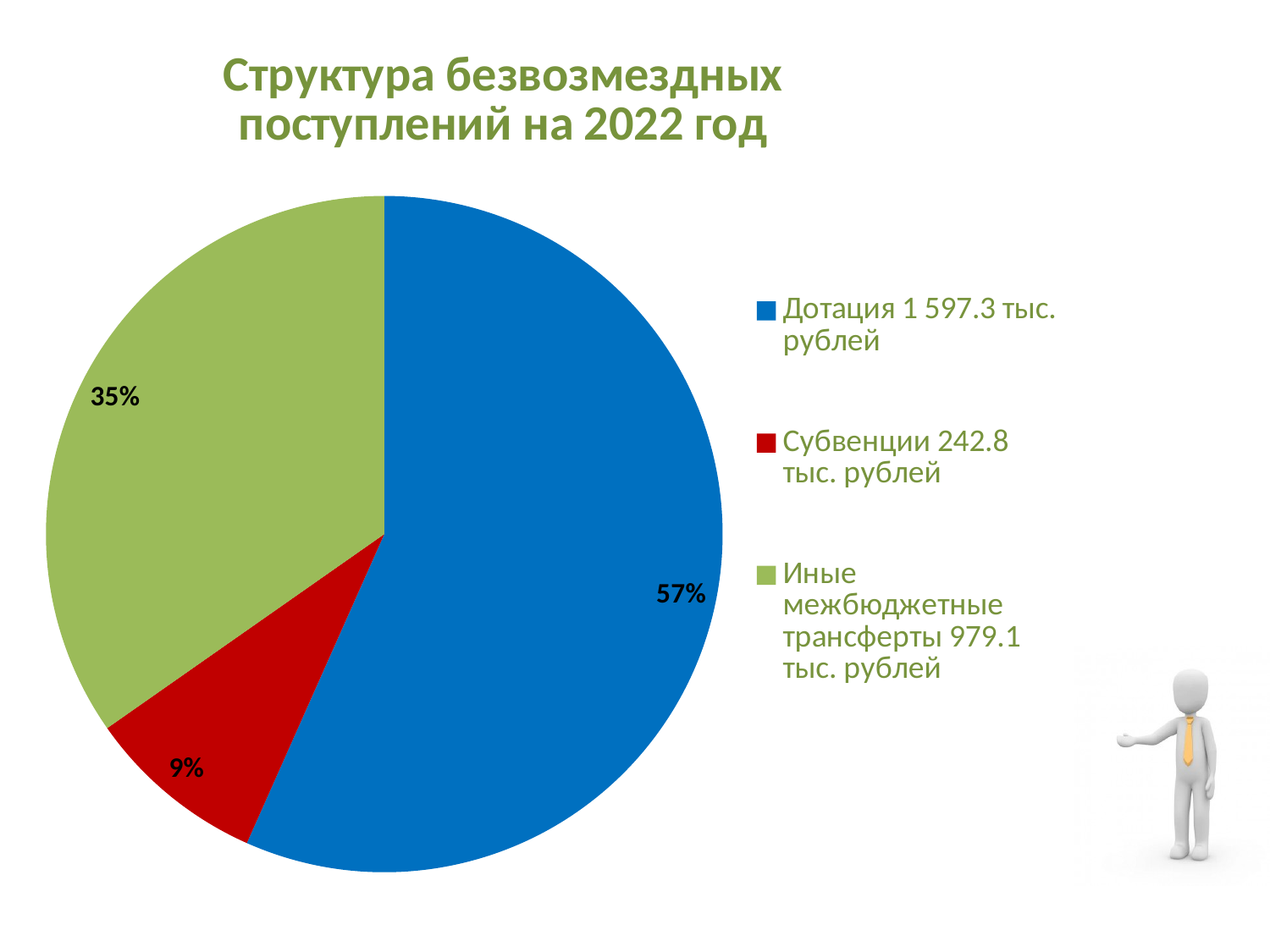
What share of the pie does Иные межбюджетные трансферты represent? 35% Which colour represents Иные межбюджетные трансферты in the chart? Green Which category has the smallest share of the pie? Субвенции Which category has the largest share of the pie? Дотация How many slices does the pie chart have? 3 What share of the pie does Дотация represent? 57% What is the title of the chart? Структура безвозмездных поступлений на 2022 год What is the amount for Субвенции according to the legend? 242.8 тыс. рублей What share of the pie does Субвенции represent? 9% What type of chart is shown on the slide? Pie chart What is the amount for Дотация according to the legend? 1 597.3 тыс. рублей What is the difference in percentage points between the Дотация share and the Иные межбюджетные трансферты share? 22 percentage points